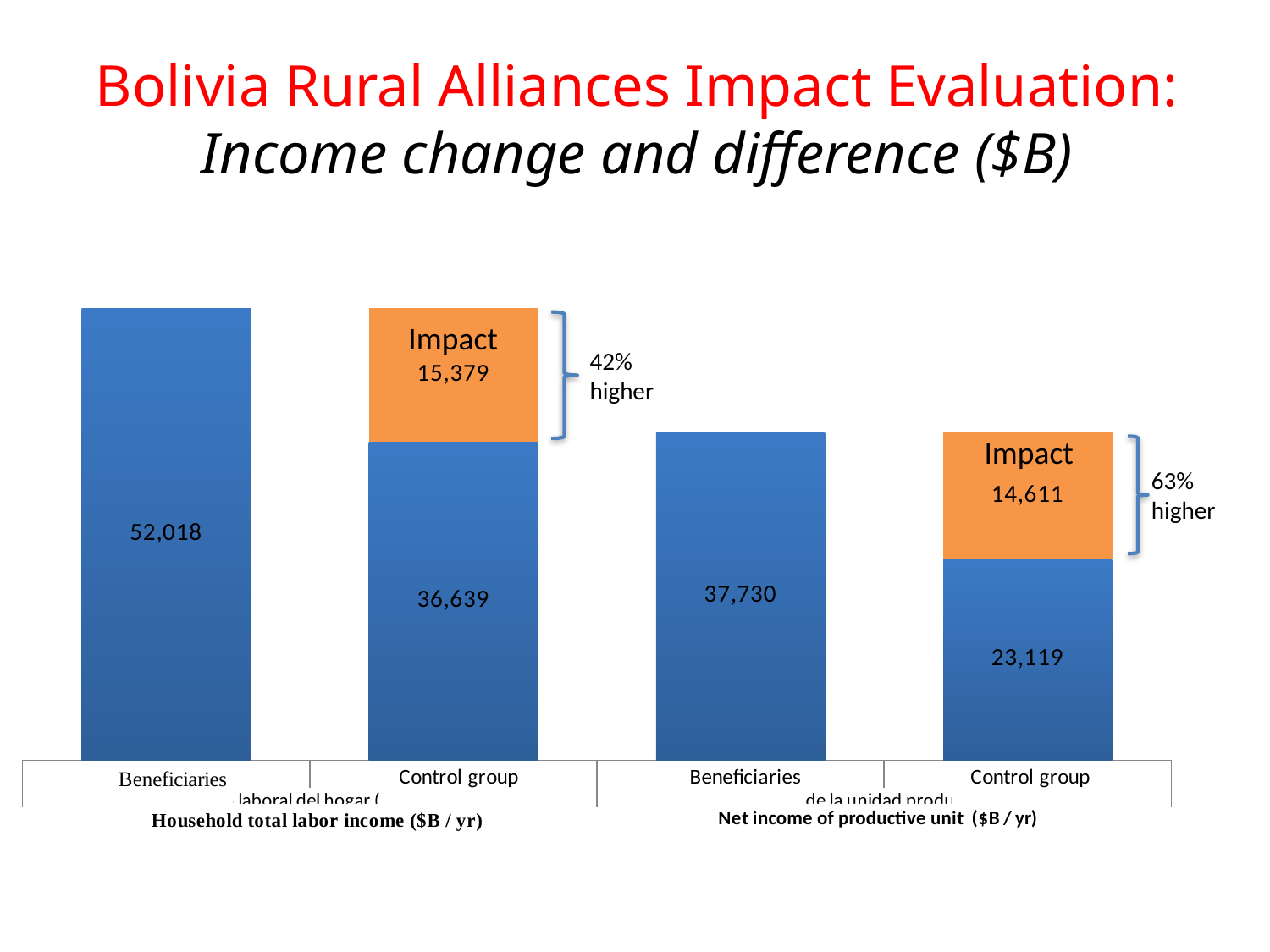
What is the net income of productive unit for Beneficiaries? 37,730 What is the total of the stacked Control group bar for net income of productive unit? 37,730 What is the household total labor income for Beneficiaries? 52,018 What is the net income of productive unit for the Control group (blue segment)? 23,119 What is the Impact value shown on the Control group bar for net income of productive unit? 14,611 What kind of chart is shown on the slide? Stacked bar chart What is the total of the stacked Control group bar for household total labor income? 52,018 What is the Impact value shown on the Control group bar for household total labor income? 15,379 What is the household total labor income for the Control group (blue segment)? 36,639 By what percentage is the Beneficiaries' net income of productive unit higher than the Control group's, according to the annotation? 63% higher What is the difference between the Beneficiaries household total labor income and the Control group blue segment? 15,379 By what percentage is the Beneficiaries' household total labor income higher than the Control group's, according to the annotation? 42% higher